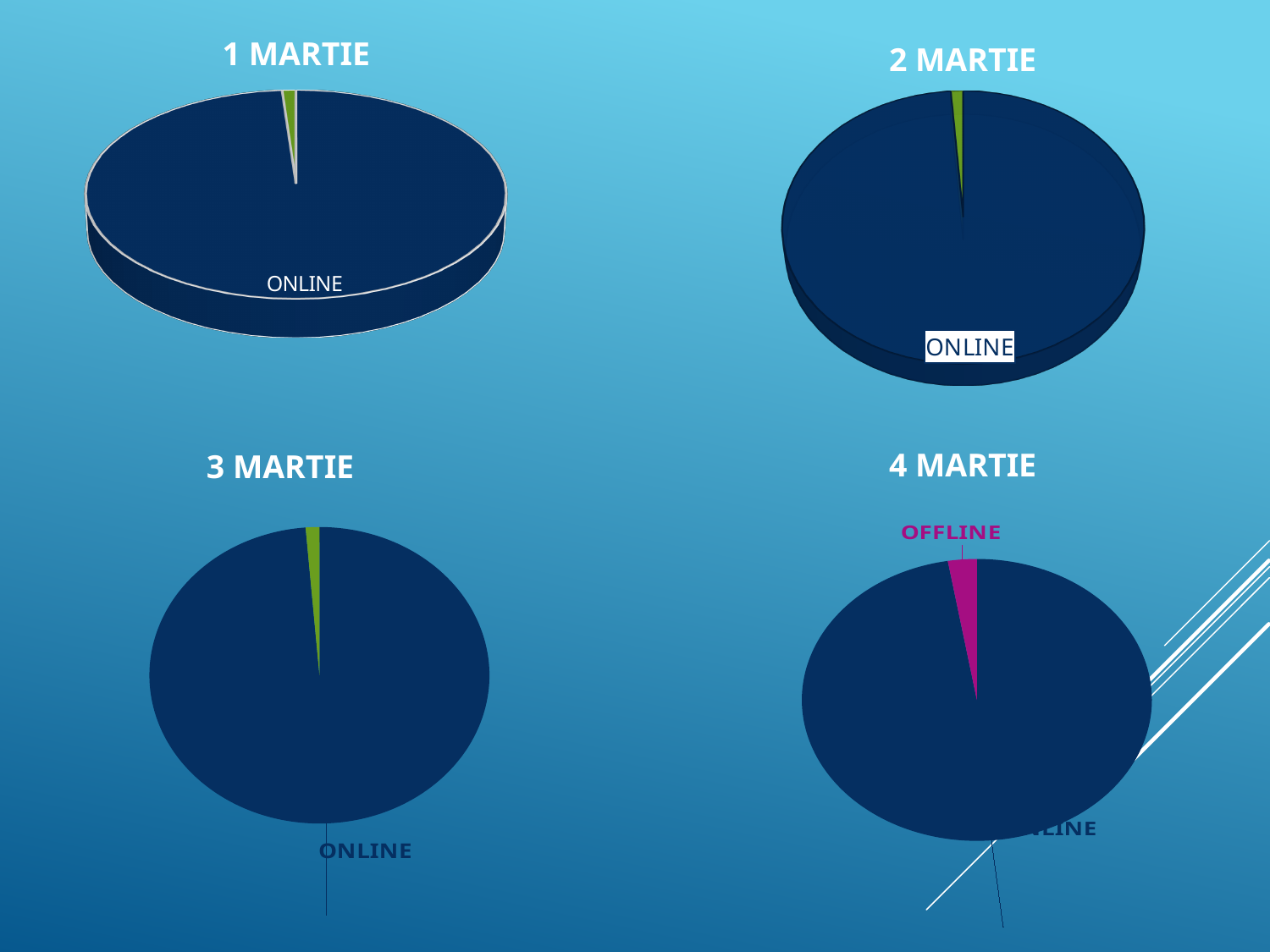
In the "4 MARTIE" chart, which slice is the smallest? OFFLINE In the "1 MARTIE" chart, which slice is the largest? ONLINE In the "2 MARTIE" chart, which slice is the largest? ONLINE How many pie charts are on the slide? 4 What is the title of the chart in the bottom-left of the slide? 3 MARTIE How many slices does the "4 MARTIE" pie chart have? 2 In the "3 MARTIE" chart, which slice is the largest? ONLINE In the "4 MARTIE" chart, which slice is larger, ONLINE or OFFLINE? ONLINE What colour is the OFFLINE slice in the "4 MARTIE" chart? Magenta What kind of chart is shown under the title "1 MARTIE"? Pie chart